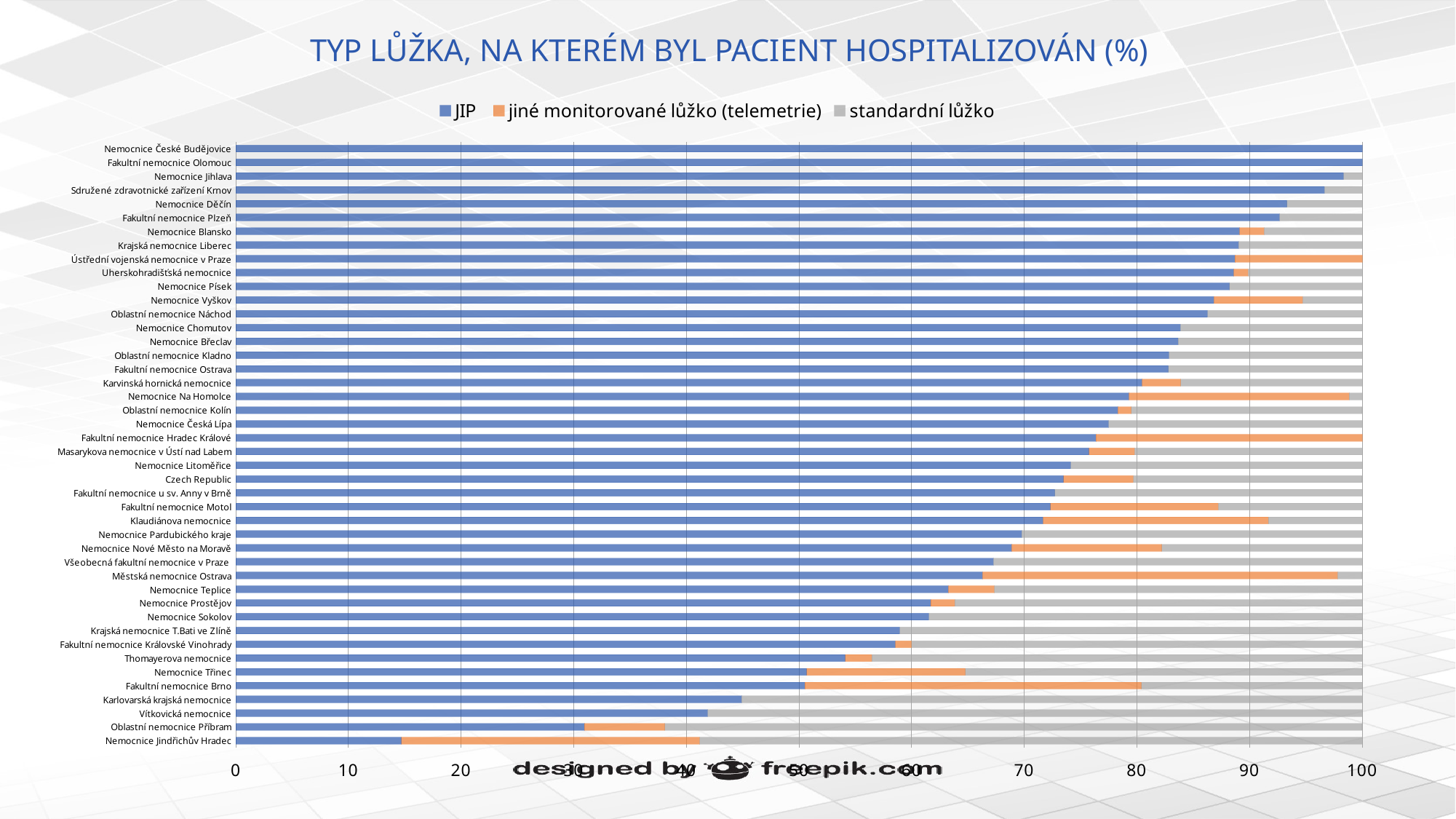
Which category has the lowest JIP value? Nemocnice Jindřichův Hradec Which colour represents the series 'jiné monitorované lůžko (telemetrie)' in the legend? Orange How many hospitals (categories) are plotted on the chart? 44 Is the JIP value for Nemocnice Jindřichův Hradec greater or less than 20? less Is the JIP value for Karlovarská krajská nemocnice greater or less than 50? less Is the JIP value for Oblastní nemocnice Příbram greater or less than 40? less Do the JIP values rise or fall going from the top category to the bottom category? fall Which has the larger JIP value, Fakultní nemocnice Brno or Vítkovická nemocnice? Fakultní nemocnice Brno What kind of chart is shown on the slide? Stacked bar chart How many series does the legend list? 3 Which has the larger JIP value, Nemocnice Děčín or Nemocnice Teplice? Nemocnice Děčín